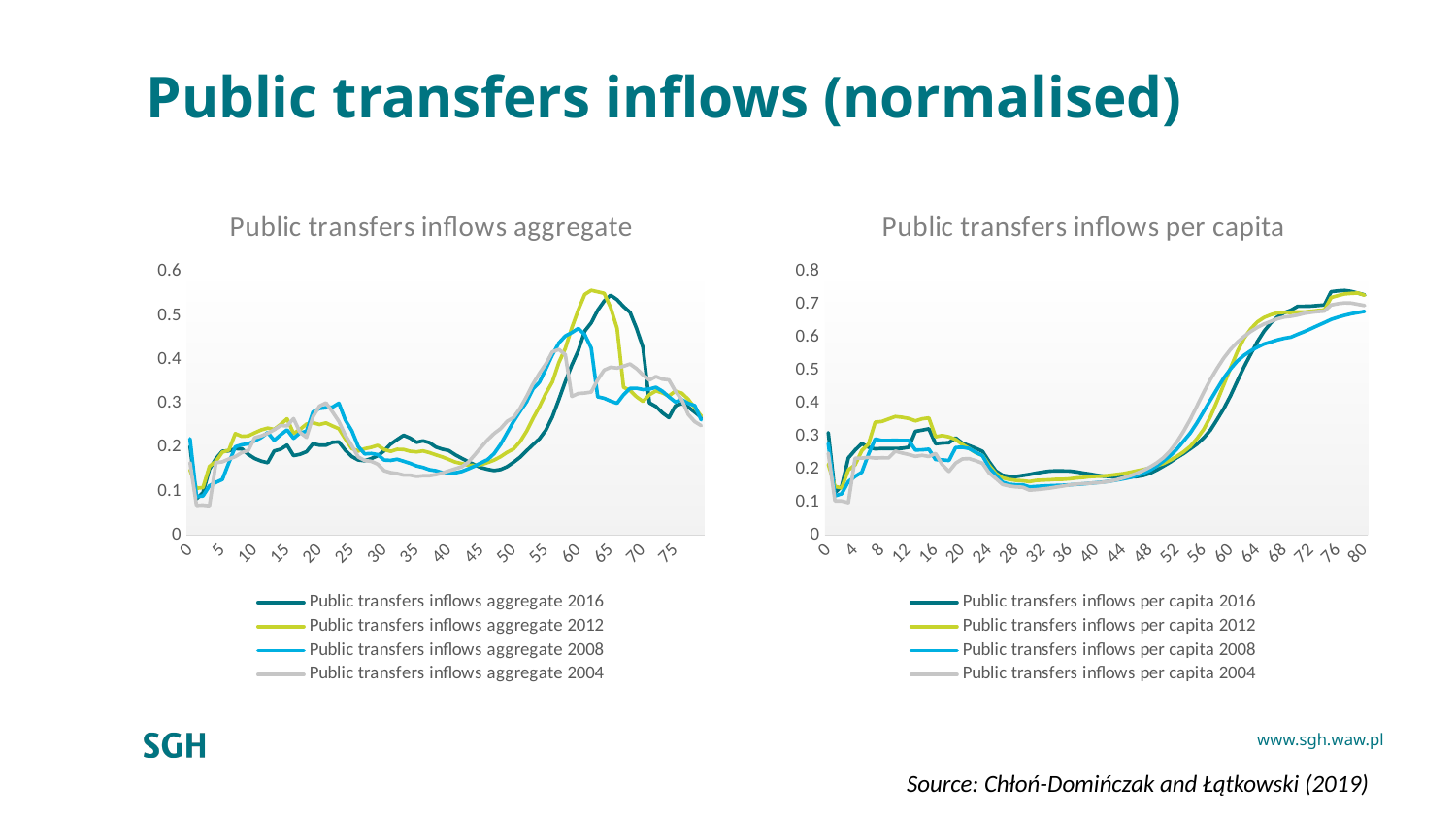
In the 'Public transfers inflows per capita' chart, does 'Public transfers inflows per capita 2016' rise or fall between age 48 and age 76? rise How many series does the legend of the 'Public transfers inflows aggregate' chart list? 4 In the 'Public transfers inflows aggregate' chart, is the peak value of 'Public transfers inflows aggregate 2012' greater or less than 0.5? greater In the 'Public transfers inflows aggregate' chart, is the value for 'Public transfers inflows aggregate 2004' at age 40 greater or less than 0.2? less How many series does the legend of the 'Public transfers inflows per capita' chart list? 4 What kind of chart is the 'Public transfers inflows aggregate' chart? line chart What is the highest value shown on the y axis of the 'Public transfers inflows per capita' chart? 0.8 In the 'Public transfers inflows per capita' chart, is the value for 'Public transfers inflows per capita 2016' at age 80 greater or less than 0.6? greater In the 'Public transfers inflows per capita' chart, at age 60, which series is higher: 'Public transfers inflows per capita 2004' or 'Public transfers inflows per capita 2016'? Public transfers inflows per capita 2004 In the 'Public transfers inflows aggregate' chart, at age 65, which series is higher: 'Public transfers inflows aggregate 2016' or 'Public transfers inflows aggregate 2008'? Public transfers inflows aggregate 2016 What kind of chart is the 'Public transfers inflows per capita' chart? line chart